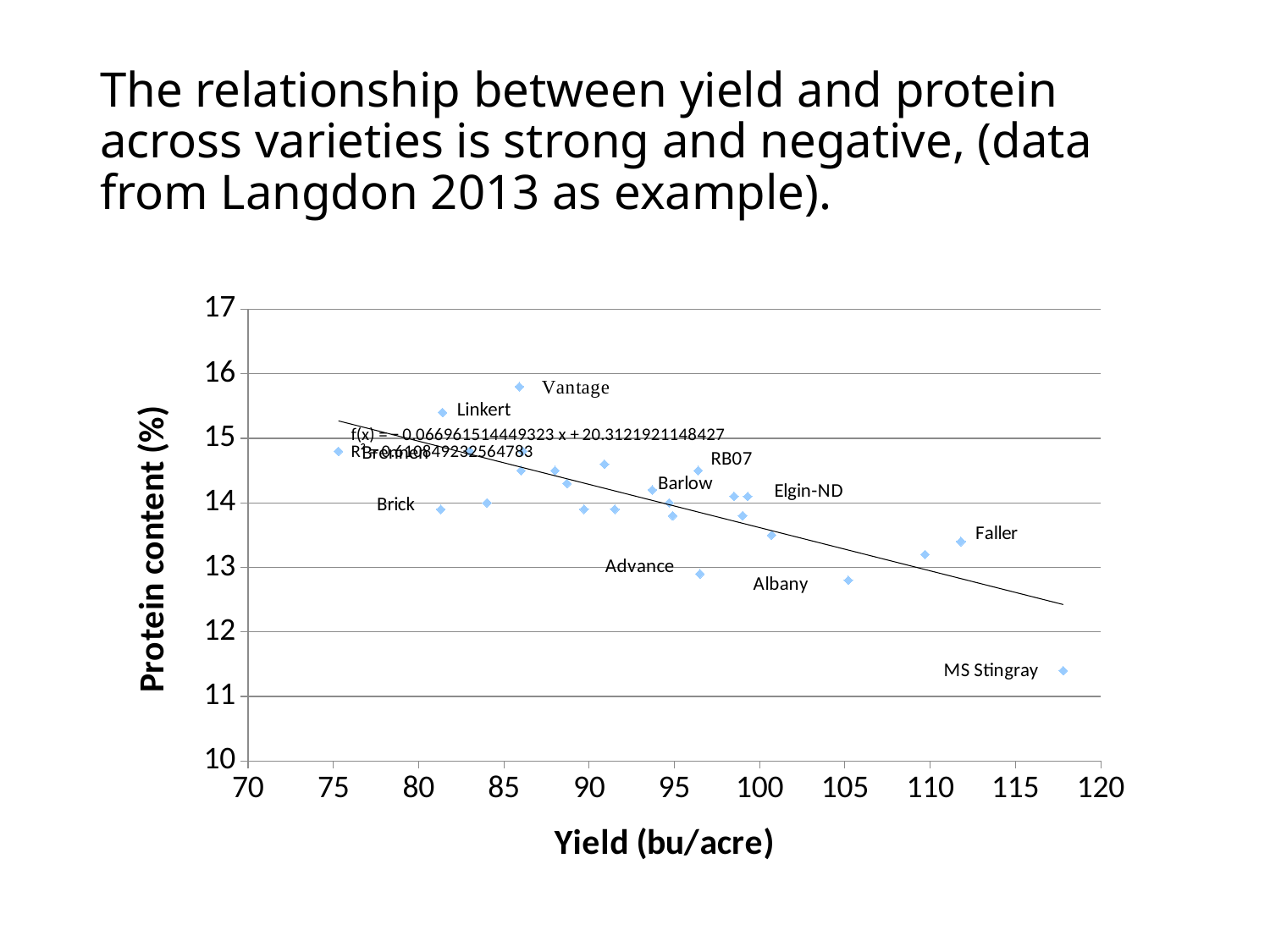
Is the yield for MS Stingray greater or less than 115? greater Which labeled variety has the lowest protein content? MS Stingray What kind of chart is shown on the slide? scatter chart Which has the higher protein content, Vantage or Linkert? Vantage Which has the higher protein content, Faller or Albany? Faller As yield increases along the x axis, does protein content generally rise or fall? fall What is the title of the y axis? Protein content (%) Is the protein content for Albany greater or less than 13? less Is the protein content for MS Stingray greater or less than 12? less Which labeled variety has the highest protein content? Vantage Which labeled variety has the highest yield? MS Stingray